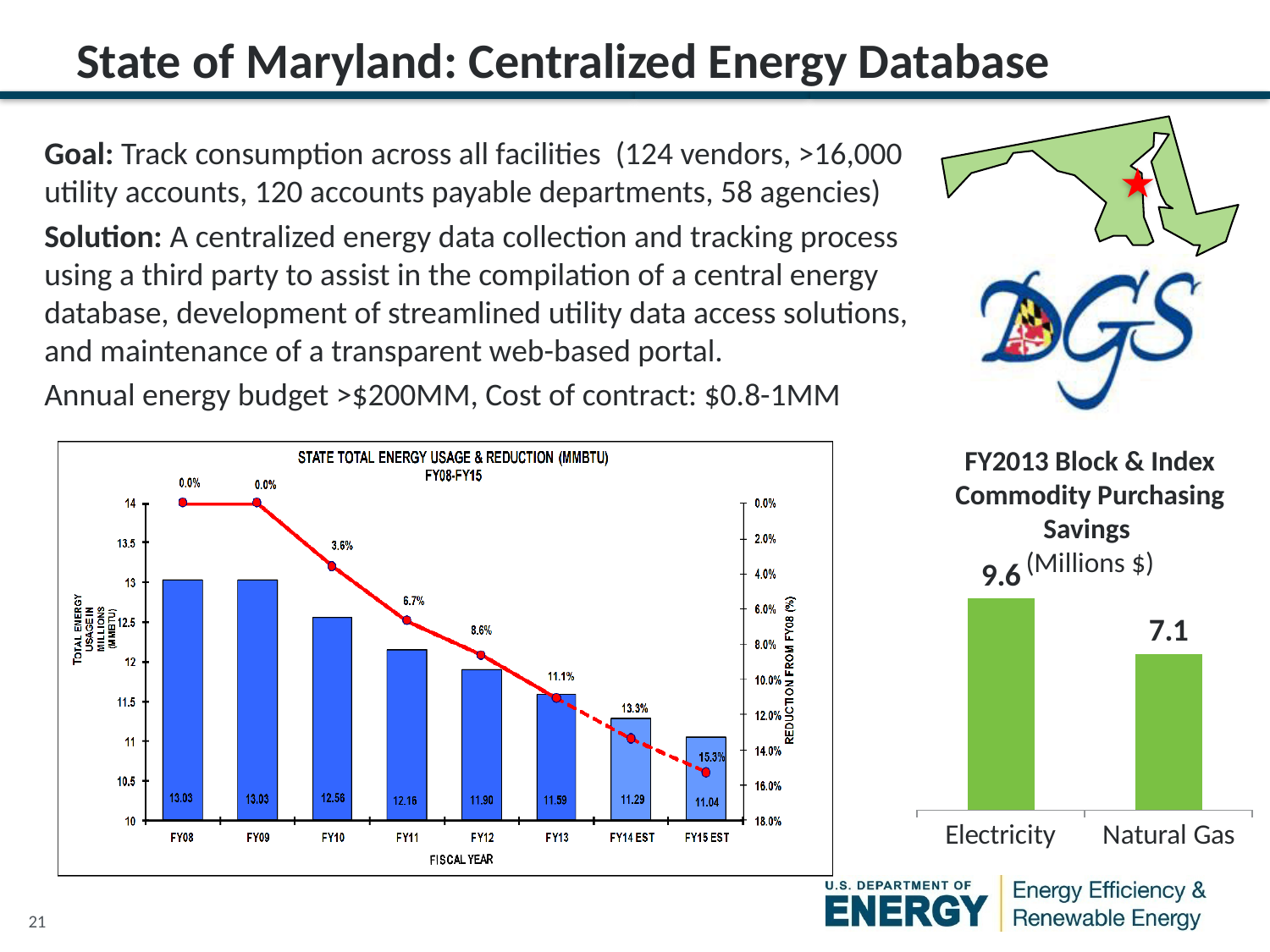
In the State Total Energy Usage & Reduction chart, what is the total energy usage for FY12? 11.90 In the State Total Energy Usage & Reduction chart, what is the reduction from FY08 shown for FY15 EST? 15.3% In the FY2013 Block & Index Commodity Purchasing Savings chart, which category has the higher savings? Electricity What type of chart is the FY2013 Block & Index Commodity Purchasing Savings chart? Bar chart In the State Total Energy Usage & Reduction chart, does total energy usage rise or fall from FY08 to FY15 EST? Fall In the FY2013 Block & Index Commodity Purchasing Savings chart, what is the value for Natural Gas? 7.1 In the FY2013 Block & Index Commodity Purchasing Savings chart, what unit is shown under the title? Millions $ In the State Total Energy Usage & Reduction chart, what is the difference in total energy usage between FY08 and FY15 EST? 1.99 In the State Total Energy Usage & Reduction chart, how many fiscal years are shown on the x axis? 8 In the FY2013 Block & Index Commodity Purchasing Savings chart, what is the difference between Electricity and Natural Gas savings? 2.5 In the State Total Energy Usage & Reduction chart, what is the reduction from FY08 shown for FY13? 11.1% In the State Total Energy Usage & Reduction chart, which fiscal year has the lowest total energy usage? FY15 EST